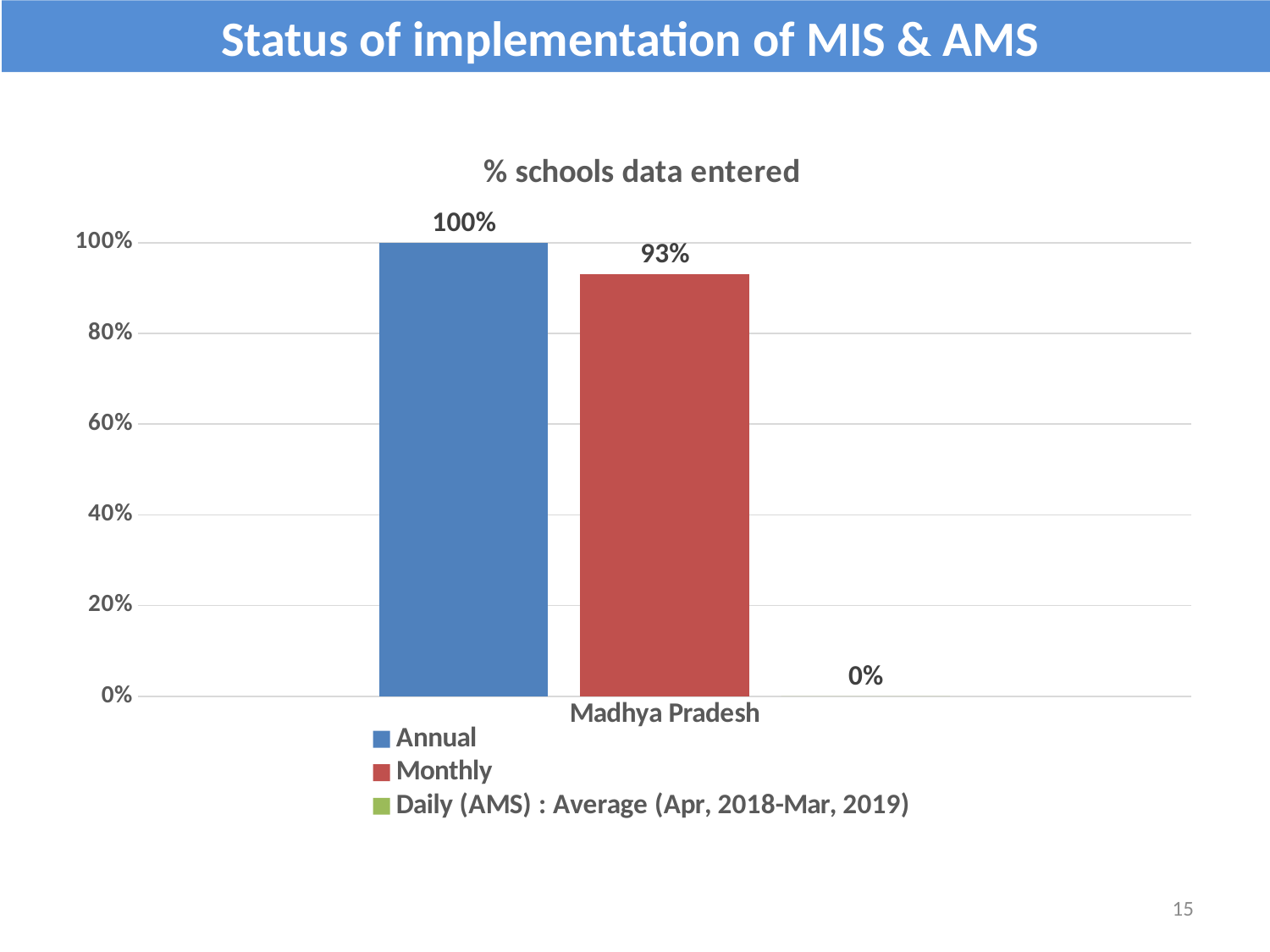
What is the title of the chart? % schools data entered Which series has the highest value for Madhya Pradesh? Annual Is the Monthly value for Madhya Pradesh greater or less than 80%? greater How many series does the legend list? 3 Which series has the lowest value for Madhya Pradesh? Daily (AMS) : Average (Apr, 2018-Mar, 2019) How many categories are shown on the x axis? 1 Which is larger for Madhya Pradesh, the Annual value or the Monthly value? Annual What is the difference between the Annual and Monthly values for Madhya Pradesh? 7% What is the value for the Daily (AMS) : Average (Apr, 2018-Mar, 2019) series for Madhya Pradesh? 0% What is the value for the Annual series for Madhya Pradesh? 100% What kind of chart is shown on the slide? Bar chart What is the value for the Monthly series for Madhya Pradesh? 93%